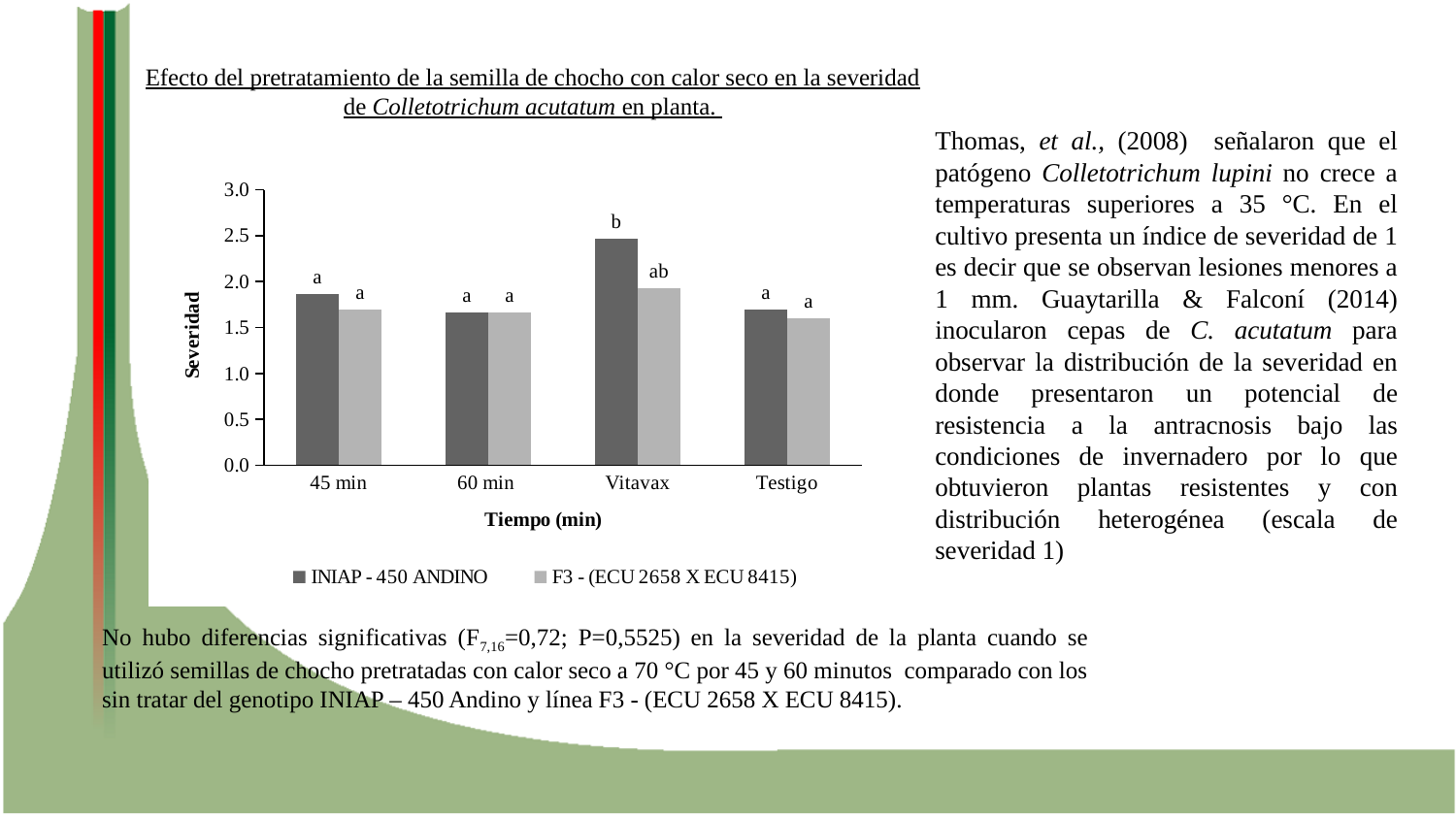
What is the title of the y axis of the chart? Severidad At Vitavax, which series has the larger severity value, INIAP - 450 ANDINO or F3 - (ECU 2658 X ECU 8415)? INIAP - 450 ANDINO Which category has the highest severity value for the F3 - (ECU 2658 X ECU 8415) series? Vitavax What kind of chart is shown on the slide? bar chart How many categories are shown on the x axis of the chart? 4 Is the severity value for INIAP - 450 ANDINO at 45 min greater or less than 2.0? less What is the title of the x axis of the chart? Tiempo (min) Which category has the highest severity value for the INIAP - 450 ANDINO series? Vitavax How many series does the chart legend list? 2 Is the severity value for INIAP - 450 ANDINO at Vitavax greater or less than 2.0? greater Is the severity value for F3 - (ECU 2658 X ECU 8415) at 60 min greater or less than 1.5? greater